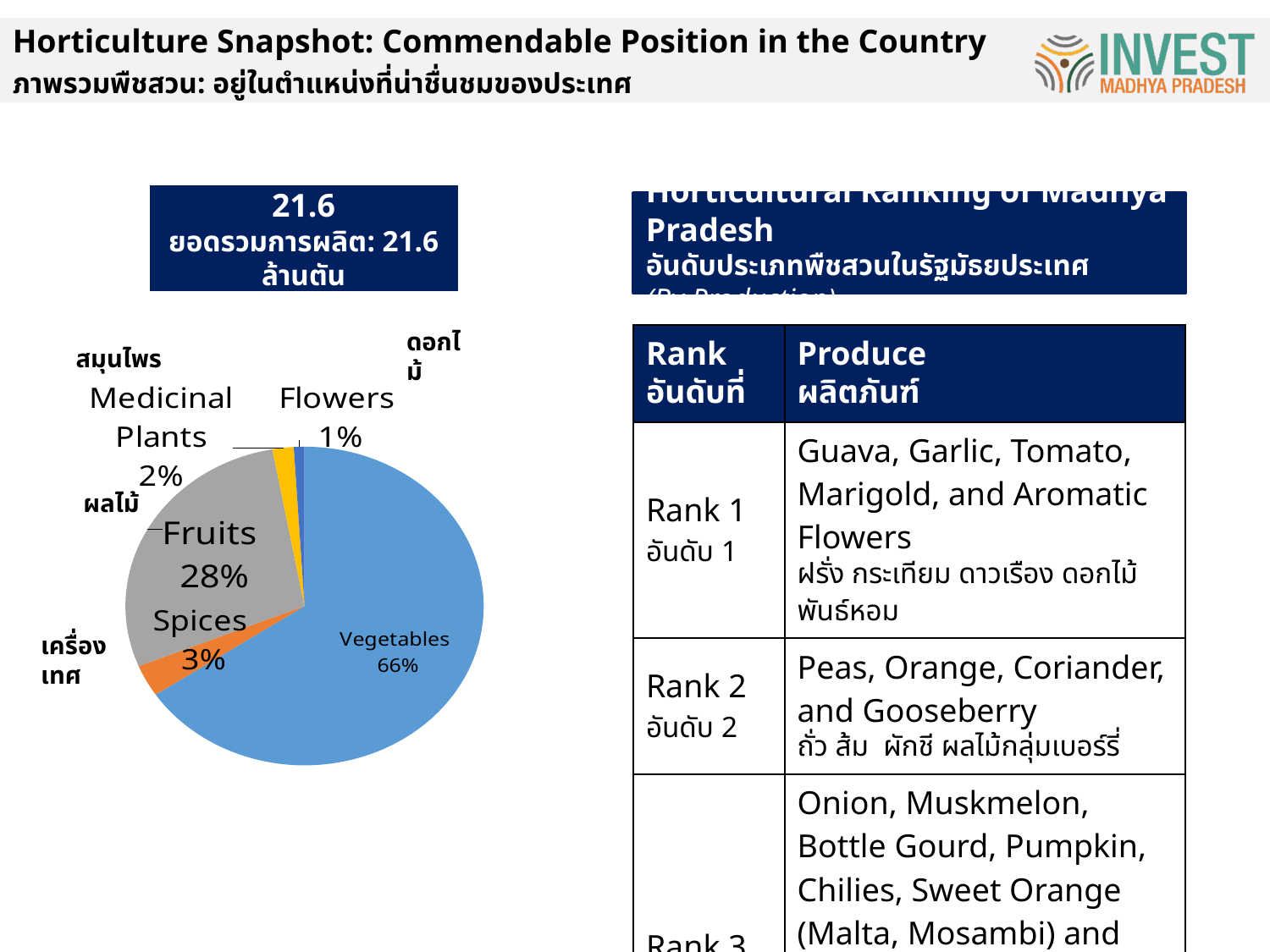
What percentage is shown for Spices in the pie chart? 3% What share of the pie chart do Fruits account for? 28% Which category has the largest slice in the pie chart? Vegetables What colour is the Vegetables slice in the pie chart? blue Which is larger in the pie chart, Spices or Medicinal Plants? Spices Which category has the smallest slice in the pie chart? Flowers What is the difference in percentage points between Vegetables and Fruits in the pie chart? 38 What share of the pie chart do Vegetables account for? 66% What percentage is shown for Medicinal Plants in the pie chart? 2% What percentage is shown for Flowers in the pie chart? 1% What type of chart is shown on the slide? pie chart How many categories are shown in the pie chart? 5